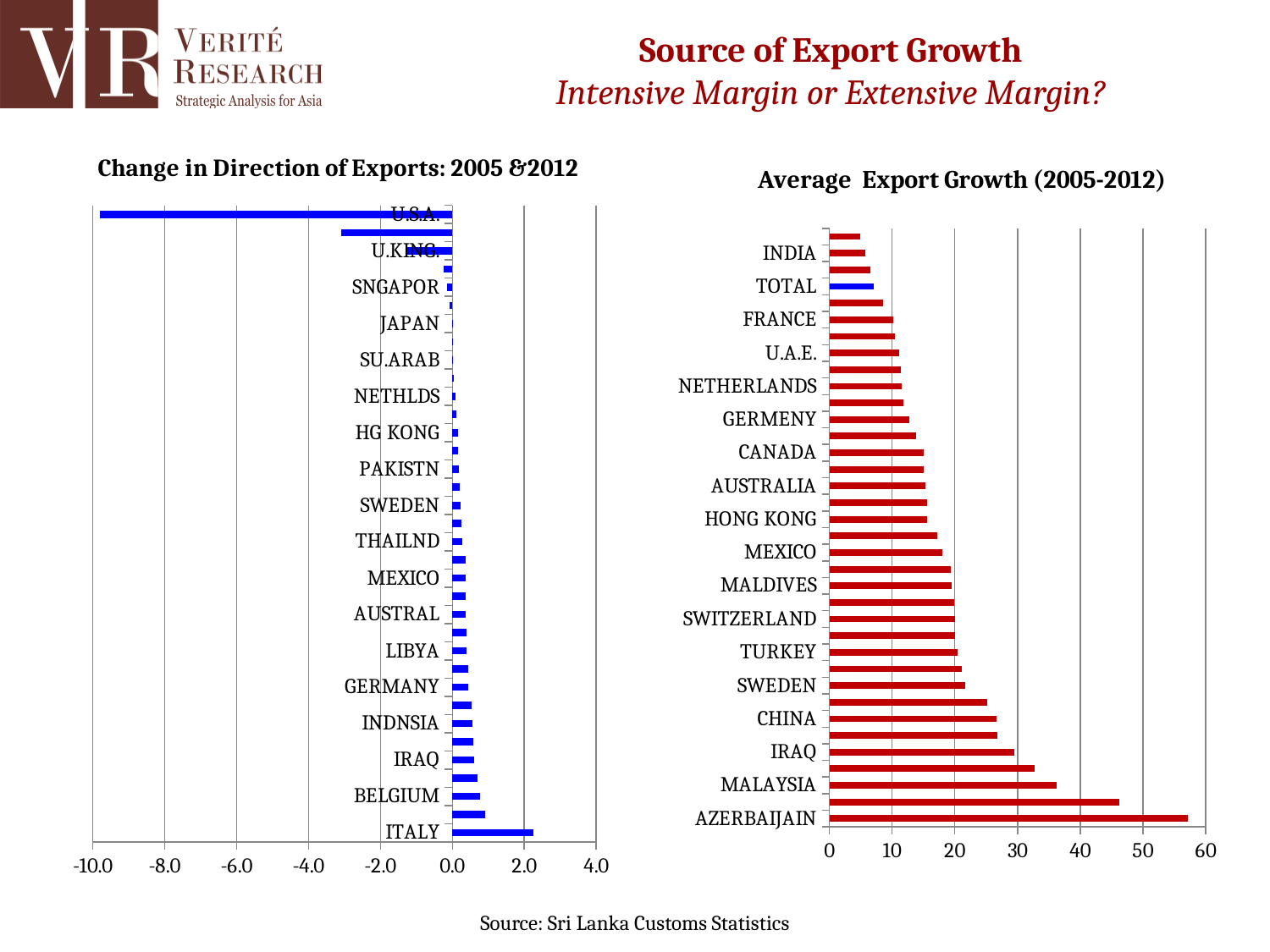
In the 'Change in Direction of Exports: 2005 & 2012' chart, is the value for U.S.A. greater or less than -8.0? less In the 'Average Export Growth (2005-2012)' chart, is the value for HONG KONG greater or less than 20? less In the 'Average Export Growth (2005-2012)' chart, which bar is shown in a different colour (blue) from the others? TOTAL What source is cited at the bottom of the slide for the charts? Sri Lanka Customs Statistics What kind of chart is the 'Average Export Growth (2005-2012)' chart on the right? bar chart In the 'Average Export Growth (2005-2012)' chart, which labelled country has the highest value? AZERBAIJAIN In the 'Average Export Growth (2005-2012)' chart, is the value for TOTAL greater or less than 10? less In the 'Average Export Growth (2005-2012)' chart, which is larger, the value for MALAYSIA or the value for CHINA? MALAYSIA In the 'Change in Direction of Exports: 2005 & 2012' chart, which labelled country has the lowest value? U.S.A.